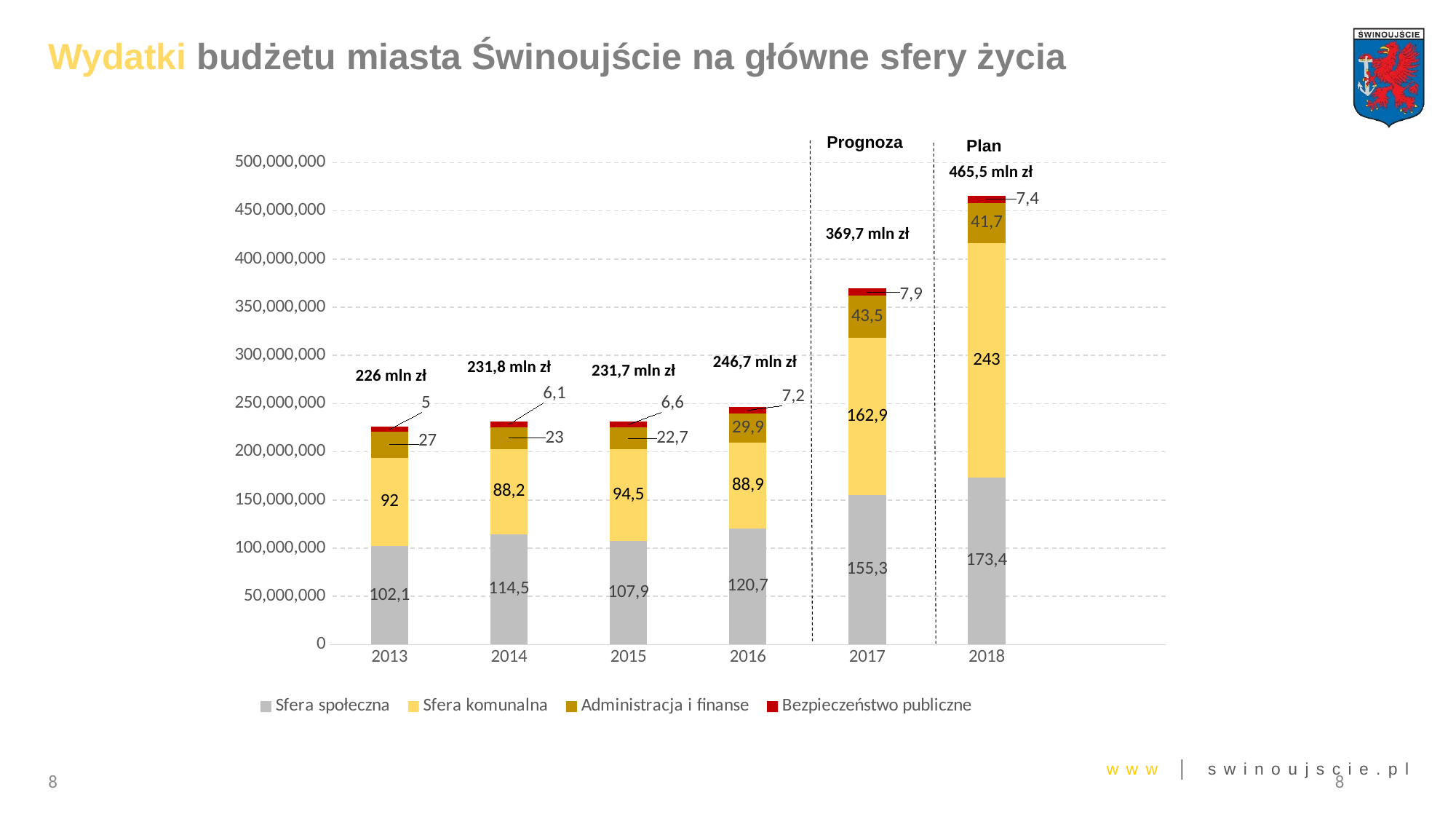
Which year has the larger Sfera komunalna value, 2014 or 2015? 2015 What is the value of Bezpieczeństwo publiczne for 2016? 7,2 Which year has the highest total expenditure? 2018 Which year has the lowest value for Sfera społeczna? 2013 What kind of chart is shown on the slide? Stacked bar chart What is the difference between the Sfera komunalna values for 2018 and 2017? 80,1 What is the value of Sfera społeczna for 2013? 102,1 What is the value of Sfera komunalna for 2018? 243 What is the total shown above the stacked bar for 2018? 465,5 mln zł How many series does the legend list? 4 What is the value of Administracja i finanse for 2017? 43,5 How many years are shown on the x axis? 6